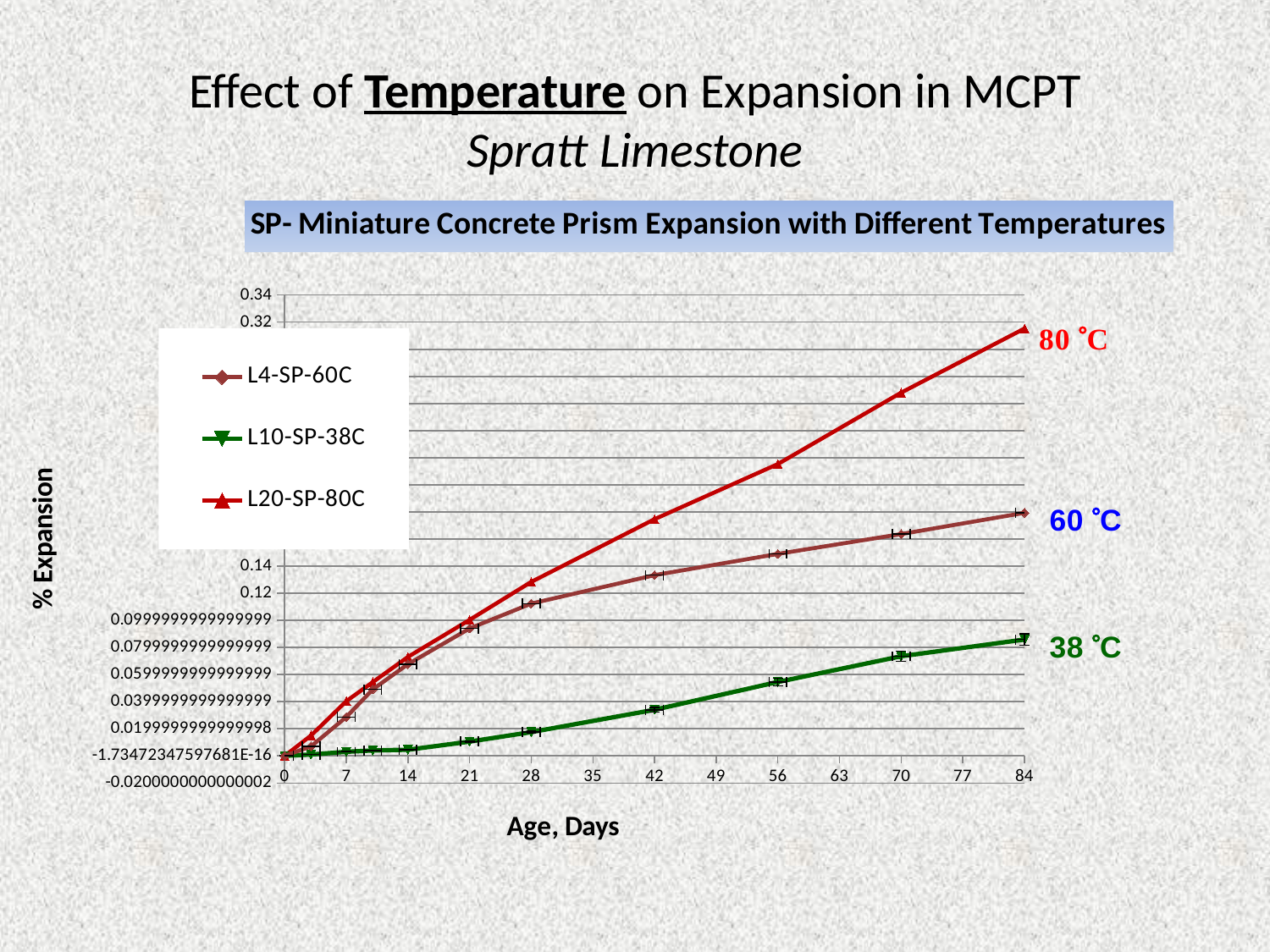
How many series does the legend list? 3 Does the expansion for L20-SP-80C rise or fall as age increases? rise Is the expansion for L10-SP-38C at 84 days greater or less than 0.12? less How many tick labels are shown on the x axis (Age, Days)? 13 Is the expansion for L20-SP-80C at 42 days greater or less than 0.14? greater Is the expansion for L4-SP-60C at 84 days greater or less than 0.14? greater What kind of chart is shown on the slide? line chart Which series has the highest expansion at 84 days? L20-SP-80C What is the title of the chart? SP- Miniature Concrete Prism Expansion with Different Temperatures Which series has the lowest expansion at 84 days? L10-SP-38C At 56 days, which series has the larger expansion, L4-SP-60C or L10-SP-38C? L4-SP-60C What is the label of the x axis? Age, Days